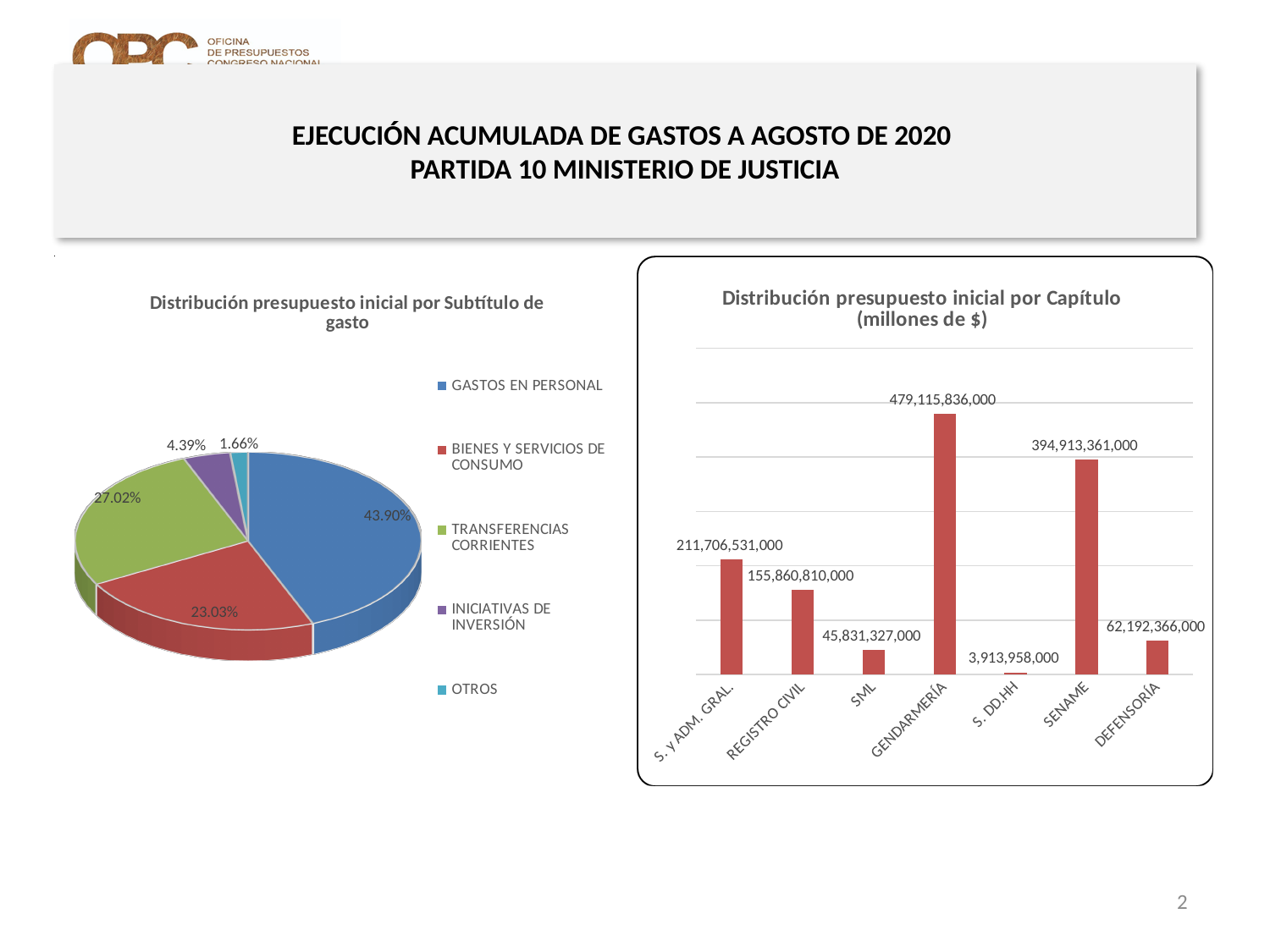
In the pie chart 'Distribución presupuesto inicial por Subtítulo de gasto', what share does TRANSFERENCIAS CORRIENTES have? 27.02% How many entries does the legend of the pie chart 'Distribución presupuesto inicial por Subtítulo de gasto' list? 5 In the pie chart 'Distribución presupuesto inicial por Subtítulo de gasto', what share does GASTOS EN PERSONAL have? 43.90% In the pie chart 'Distribución presupuesto inicial por Subtítulo de gasto', which category has the smallest share? OTROS In the chart 'Distribución presupuesto inicial por Capítulo (millones de $)', what is the value for REGISTRO CIVIL? 155,860,810,000 In the chart 'Distribución presupuesto inicial por Capítulo (millones de $)', what is the difference between the values for GENDARMERÍA and SENAME? 84,202,475,000 In the chart 'Distribución presupuesto inicial por Capítulo (millones de $)', which category has the lowest value? S. DD.HH In the chart 'Distribución presupuesto inicial por Capítulo (millones de $)', which category has the highest value? GENDARMERÍA How many categories are shown in the chart 'Distribución presupuesto inicial por Capítulo (millones de $)'? 7 In the chart 'Distribución presupuesto inicial por Capítulo (millones de $)', what is the value for GENDARMERÍA? 479,115,836,000 What kind of chart is 'Distribución presupuesto inicial por Capítulo (millones de $)'? Bar chart In the chart 'Distribución presupuesto inicial por Capítulo (millones de $)', which is larger, the value for SML or the value for DEFENSORÍA? DEFENSORÍA